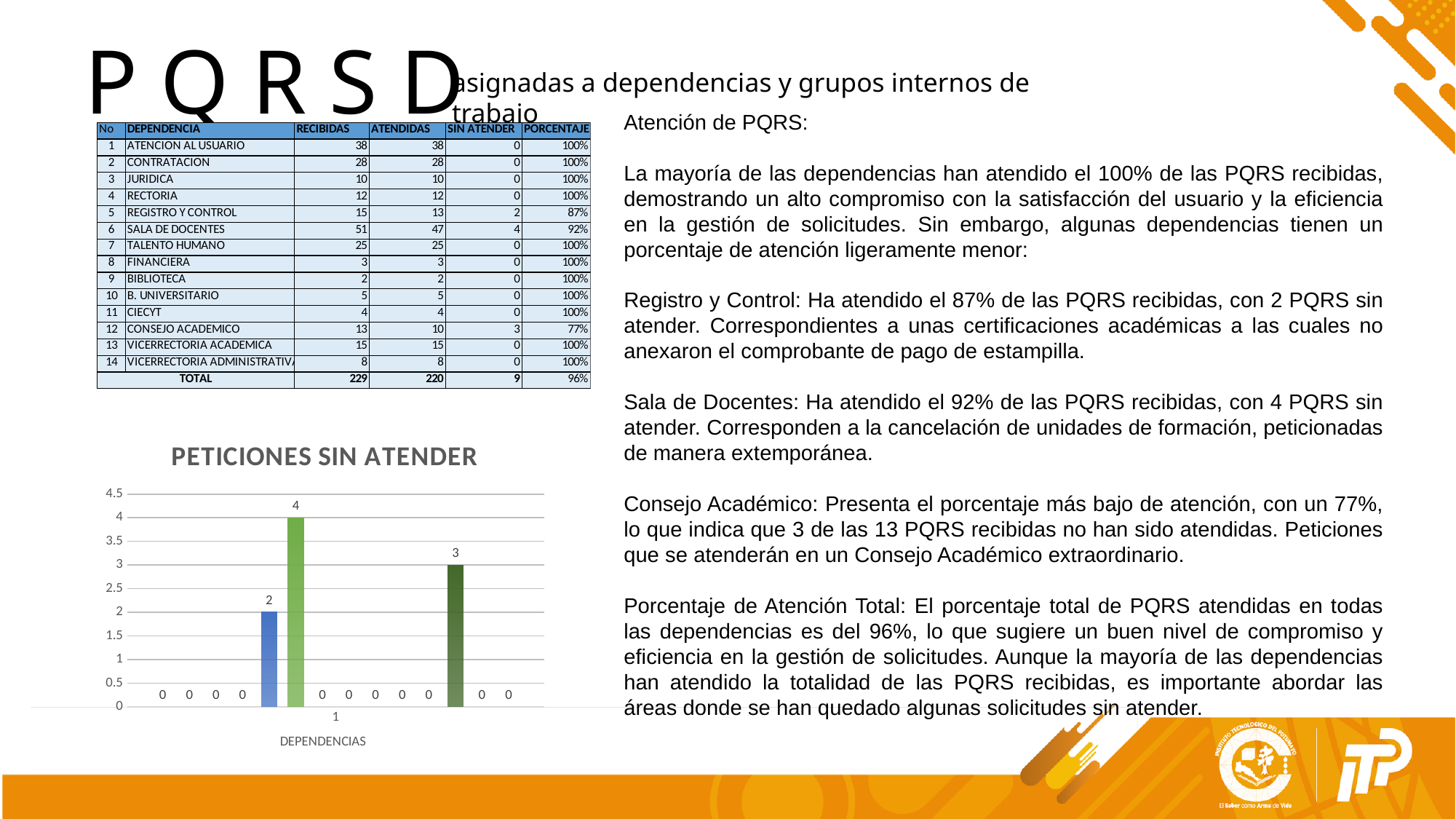
In the 'PETICIONES SIN ATENDER' chart, is the tallest bar greater or less than 3.5? greater In the 'PETICIONES SIN ATENDER' chart, what is the difference between the tallest bar and the second tallest bar? 1 In the 'PETICIONES SIN ATENDER' chart, which is larger: the blue bar or the dark green bar? the dark green bar How many bars (series) are plotted in the 'PETICIONES SIN ATENDER' chart? 14 In the 'PETICIONES SIN ATENDER' chart, what is the sum of all the bar values? 9 What kind of chart is 'PETICIONES SIN ATENDER'? bar chart In the 'PETICIONES SIN ATENDER' chart, what is the value of the light green bar? 4 In the 'PETICIONES SIN ATENDER' chart, how many bars have a value greater than 0? 3 What is the title of the chart on the slide? PETICIONES SIN ATENDER What is the label shown under the x axis of the 'PETICIONES SIN ATENDER' chart? DEPENDENCIAS In the 'PETICIONES SIN ATENDER' chart, what is the highest value shown by any bar? 4 In the 'PETICIONES SIN ATENDER' chart, what is the value of the blue bar? 2